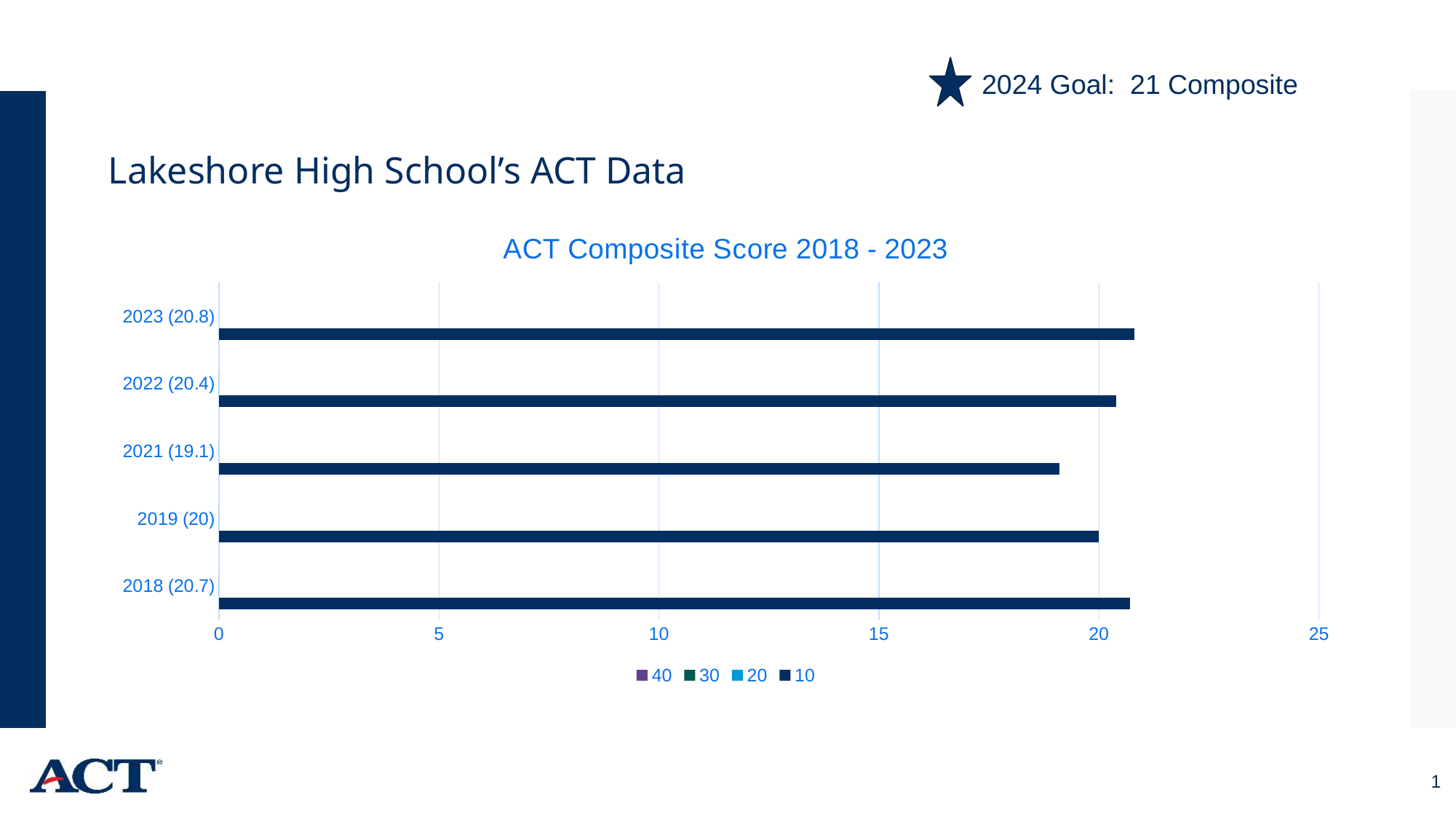
What kind of chart is shown on the slide? bar chart What is the ACT composite score for 2021? 19.1 Which is larger, the composite score for 2022 or for 2021? 2022 What is the ACT composite score for 2023? 20.8 Is the value for 2021 greater or less than 20? less What is the title of the chart? ACT Composite Score 2018 - 2023 Which year has the lowest ACT composite score? 2021 How many entries does the legend list? 4 How many years are shown in the chart? 5 Which year has the highest ACT composite score? 2023 What is the ACT composite score for 2019? 20 What is the difference between the 2023 and 2021 composite scores? 1.7